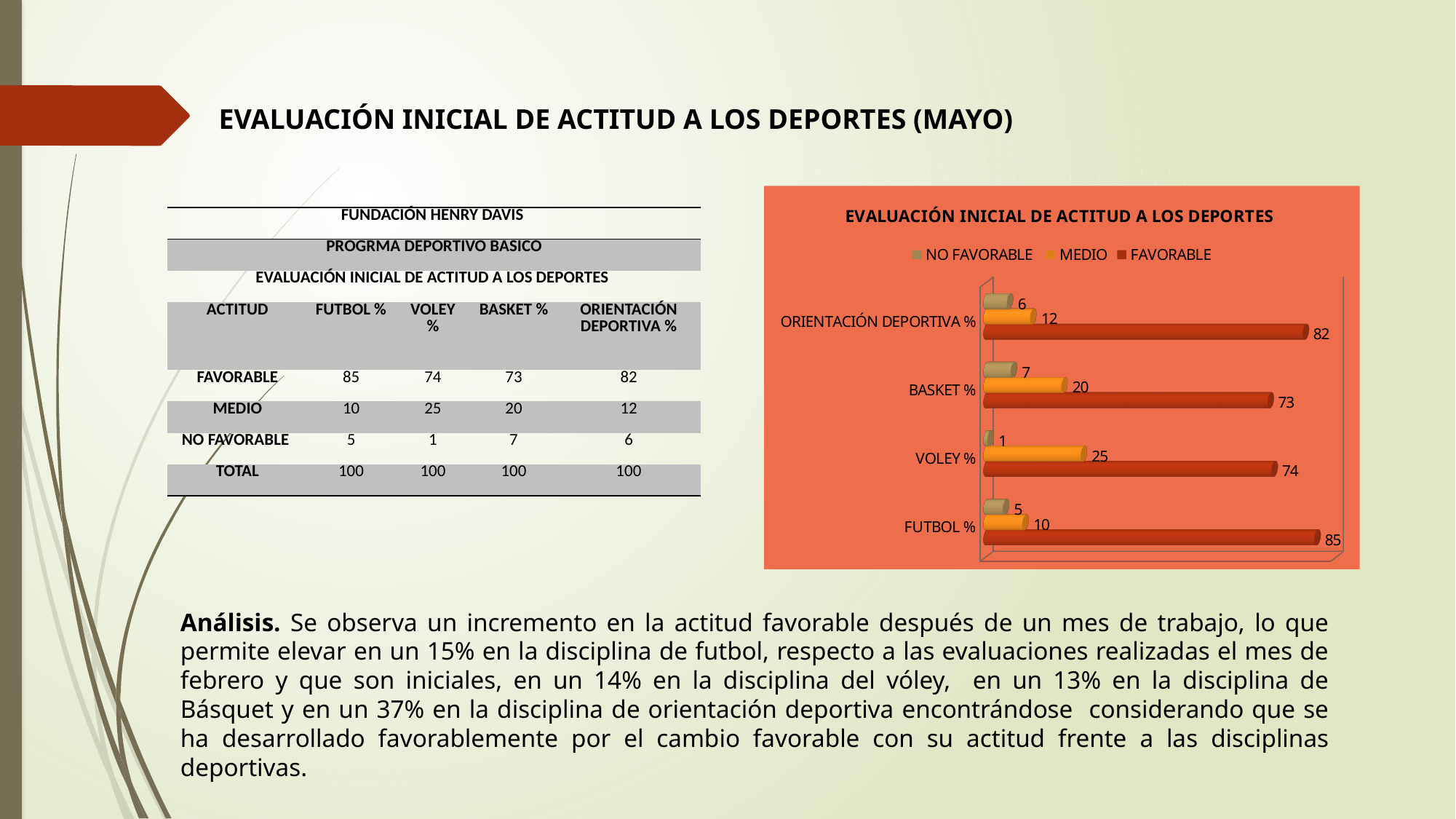
Which category has the lowest NO FAVORABLE value? VOLEY % What is the NO FAVORABLE value for BASKET % in the chart? 7 What is the title of the chart? EVALUACIÓN INICIAL DE ACTITUD A LOS DEPORTES What is the difference between the FAVORABLE values for FUTBOL % and BASKET %? 12 Which is larger, the MEDIO value for BASKET % or the MEDIO value for ORIENTACIÓN DEPORTIVA %? BASKET % What is the MEDIO value for VOLEY % in the chart? 25 How many series does the chart legend list? 3 Which category has the highest FAVORABLE value? FUTBOL % How many categories are shown on the chart? 4 What is the FAVORABLE value for ORIENTACIÓN DEPORTIVA % in the chart? 82 What kind of chart is shown on the slide? Bar chart What is the FAVORABLE value for FUTBOL % in the chart? 85